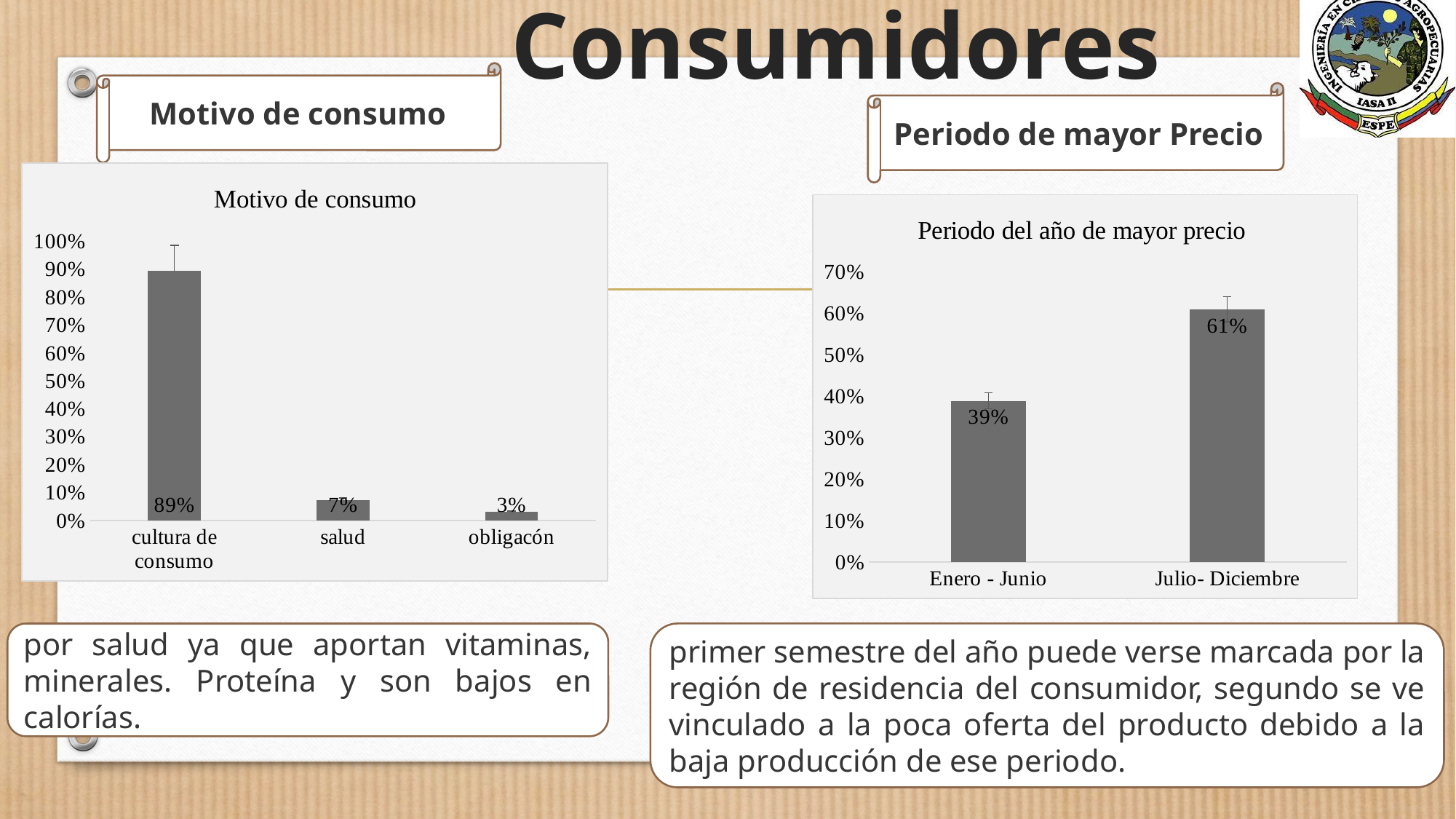
What kind of chart is the 'Periodo del año de mayor precio' chart? bar chart In the 'Motivo de consumo' chart, what is the value for 'salud'? 7% In the 'Periodo del año de mayor precio' chart, which period has the higher value, 'Enero - Junio' or 'Julio- Diciembre'? Julio- Diciembre In the 'Motivo de consumo' chart, how many categories are shown? 3 In the 'Periodo del año de mayor precio' chart, what is the value for 'Enero - Junio'? 39% In the 'Motivo de consumo' chart, what is the difference between 'cultura de consumo' and 'salud'? 82% In the 'Motivo de consumo' chart, which category has the highest value? cultura de consumo In the 'Periodo del año de mayor precio' chart, is the value for 'Enero - Junio' greater or less than 50%? less In the 'Motivo de consumo' chart, what is the value for 'cultura de consumo'? 89% In the 'Periodo del año de mayor precio' chart, what is the value for 'Julio- Diciembre'? 61% In the 'Periodo del año de mayor precio' chart, what is the difference between 'Julio- Diciembre' and 'Enero - Junio'? 22% In the 'Motivo de consumo' chart, which category has the lowest value? obligacón